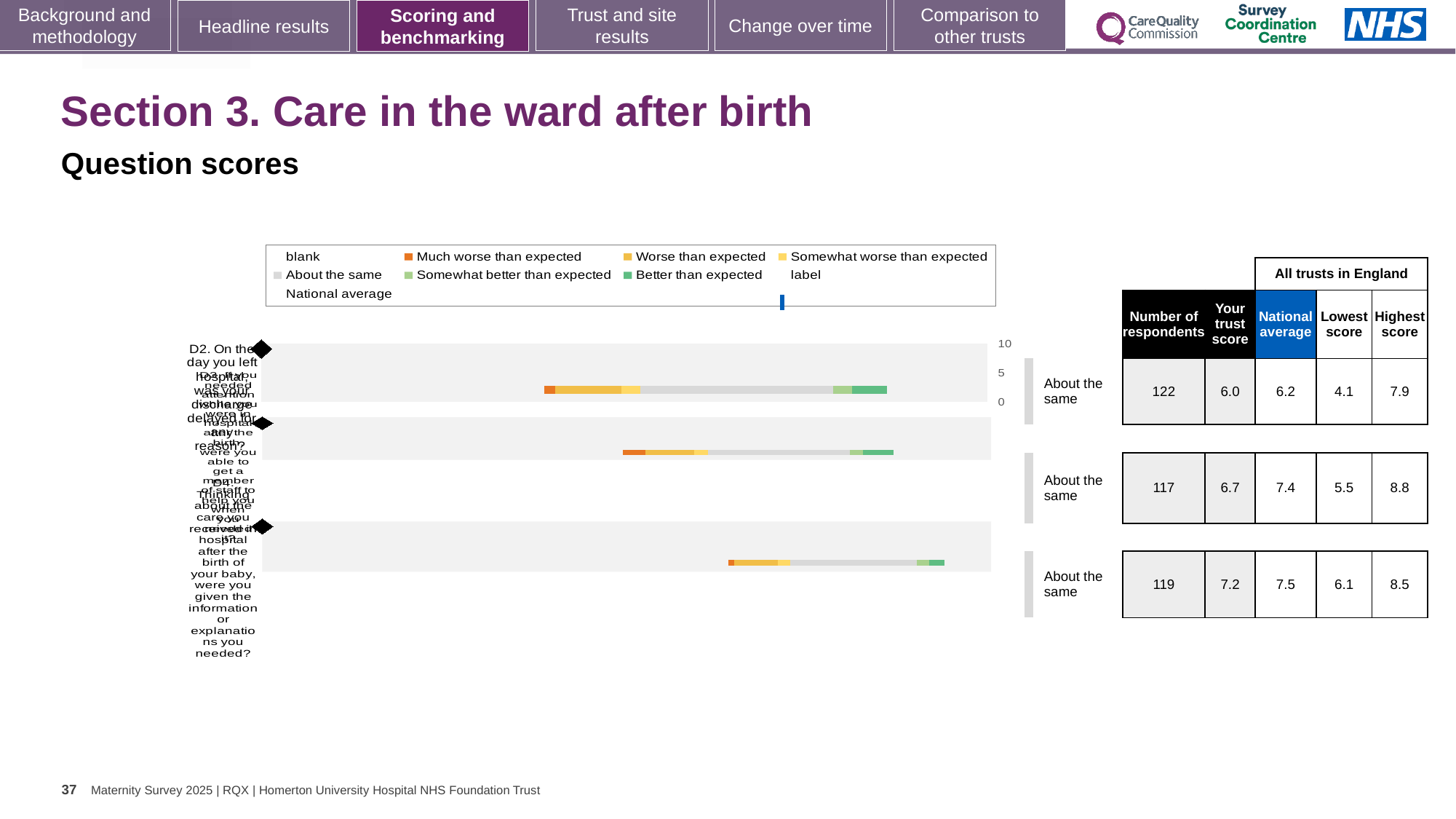
Which question row has the lowest number of respondents in the table: the first, second or third? second In the table next to the chart, what is the number of respondents for the first (top) question row? 122 In the legend, what colour represents 'Much worse than expected'? orange Is the trust score for the first (top) question row larger or smaller than its national average? smaller In the legend, what colour represents 'Better than expected'? green How many question rows (bars) are plotted in the chart? 3 In the table next to the chart, what is the trust score for the first (top) question row? 6.0 In the table next to the chart, what is the highest score for the third (bottom) question row? 8.5 Which question row has the highest trust score in the table: the first, second or third? third What kind of chart is shown on the slide? bar chart In the table next to the chart, what is the national average for the second (middle) question row? 7.4 What is the difference between the national average and the trust score for the second (middle) question row? 0.7